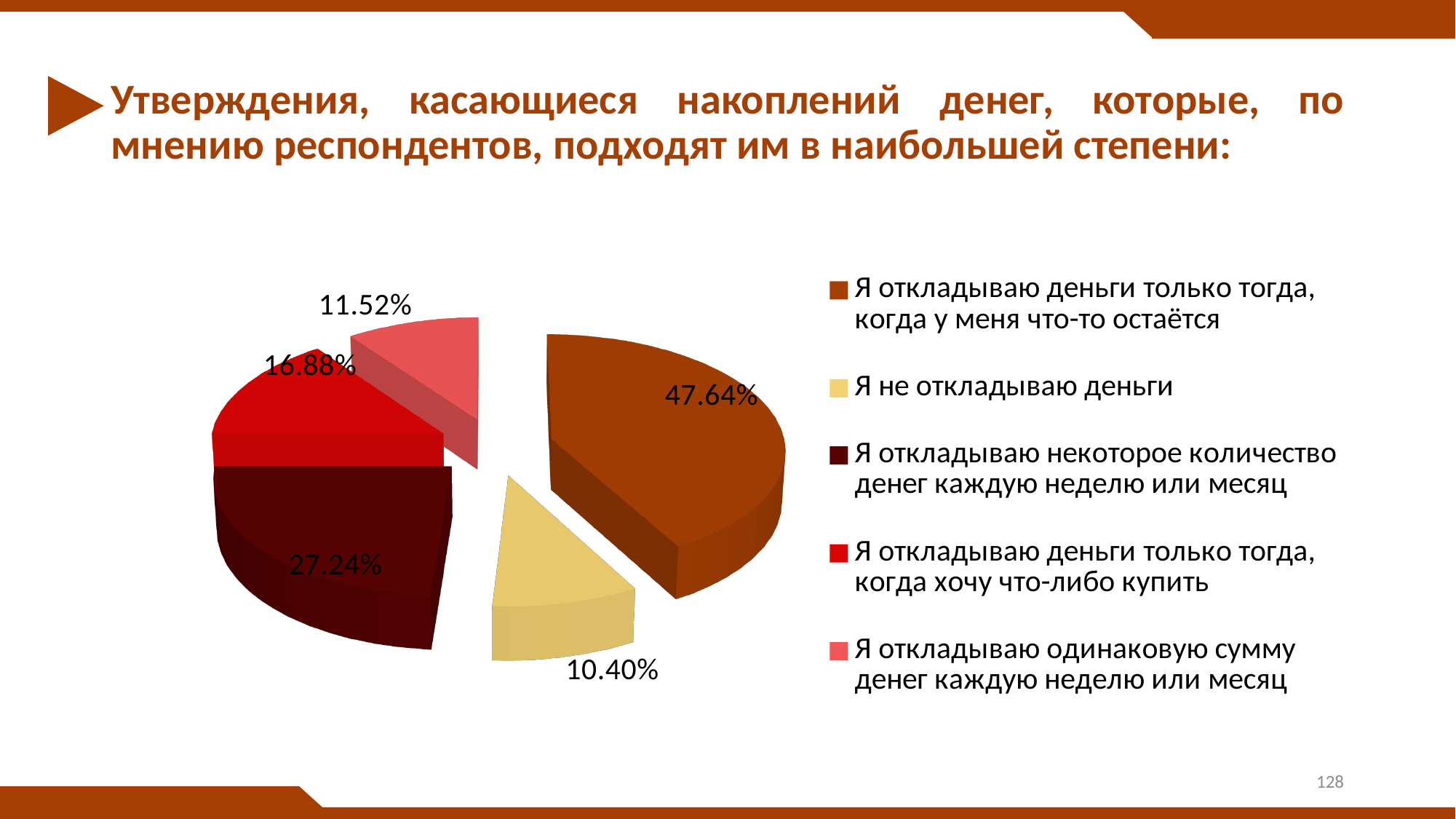
What share of respondents chose "Я откладываю некоторое количество денег каждую неделю или месяц"? 27.24% How many slices does the pie chart have? 5 Which statement has the largest share in the pie chart? Я откладываю деньги только тогда, когда у меня что-то остаётся What share of respondents chose "Я не откладываю деньги"? 10.40% What colour is the slice for "Я не откладываю деньги"? Yellow What share of respondents chose "Я откладываю одинаковую сумму денег каждую неделю или месяц"? 11.52% What kind of chart is shown on the slide? Pie chart What share of respondents chose "Я откладываю деньги только тогда, когда у меня что-то остаётся"? 47.64% What share of respondents chose "Я откладываю деньги только тогда, когда хочу что-либо купить"? 16.88% Which has a larger share: "Я откладываю деньги только тогда, когда хочу что-либо купить" or "Я откладываю одинаковую сумму денег каждую неделю или месяц"? Я откладываю деньги только тогда, когда хочу что-либо купить What is the difference in percentage points between "Я откладываю деньги только тогда, когда у меня что-то остаётся" and "Я откладываю некоторое количество денег каждую неделю или месяц"? 20.40 Which statement has the smallest share in the pie chart? Я не откладываю деньги